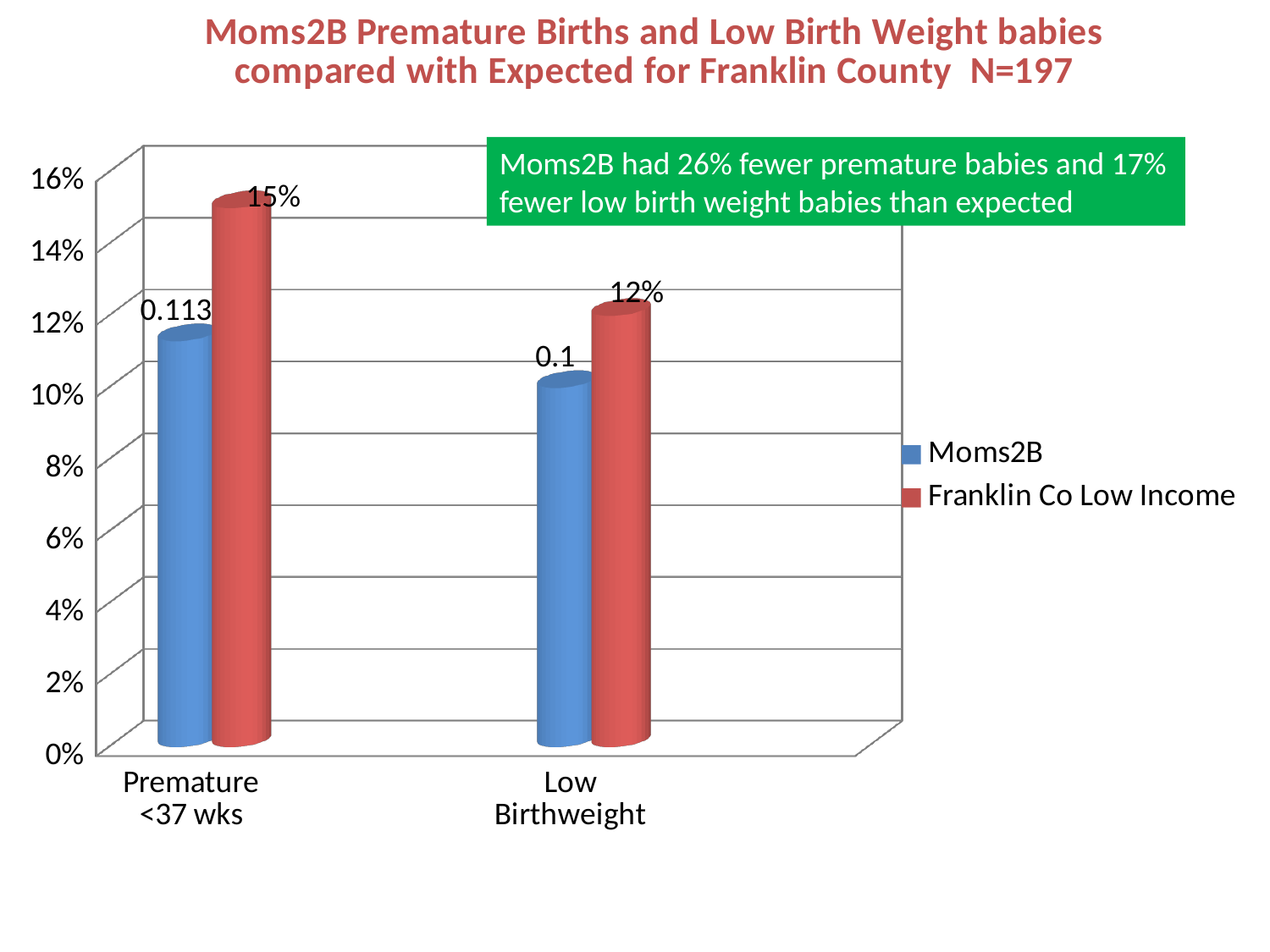
What kind of chart is shown on the slide? Bar chart What is the Moms2B value for Low Birthweight? 0.1 Is the Franklin Co Low Income value for Low Birthweight greater or less than 10%? greater Which category has the highest Franklin Co Low Income value? Premature <37 wks How many categories are shown on the x axis? 2 What is the Moms2B value for Premature <37 wks? 0.113 Is the Moms2B value for Premature <37 wks greater or less than 12%? less Which series has the higher value for Premature <37 wks, Moms2B or Franklin Co Low Income? Franklin Co Low Income What is the Franklin Co Low Income value for Premature <37 wks? 15% Which series has the higher value for Low Birthweight, Moms2B or Franklin Co Low Income? Franklin Co Low Income What is the Franklin Co Low Income value for Low Birthweight? 12% How many series does the legend list? 2